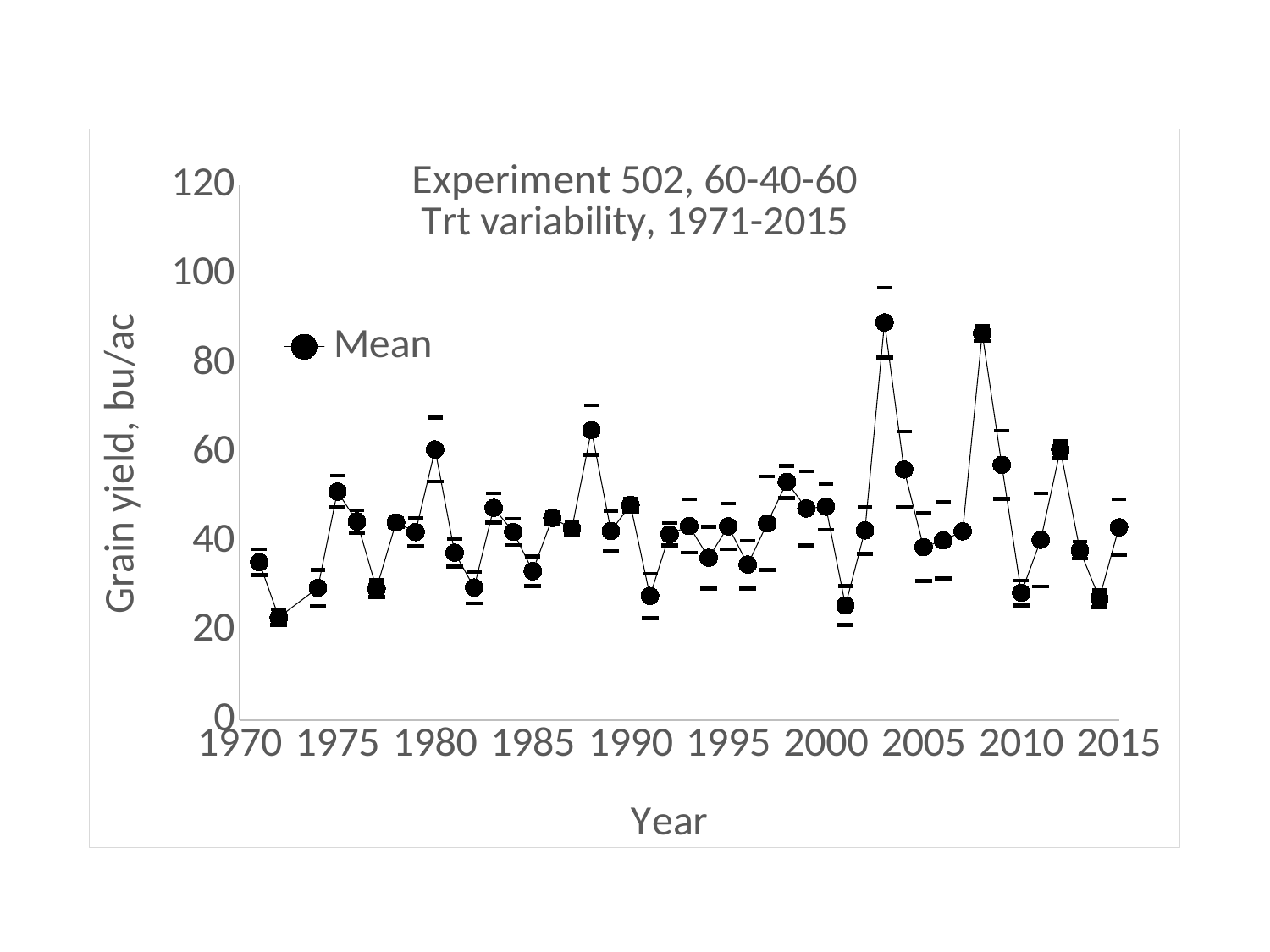
Is the mean grain yield for 2010 greater or less than 40? less Is the mean grain yield for 1980 greater or less than 40? greater What kind of chart is shown on the slide? line chart How many series does the legend list? 1 What is the label of the y axis? Grain yield, bu/ac Is the mean grain yield for 2003 greater or less than 80? greater Which year has the larger mean grain yield, 2003 or 1972? 2003 Which year has the larger mean grain yield, 1988 or 1991? 1988 What is the title of the chart? Experiment 502, 60-40-60 Trt variability, 1971-2015 Which year has the larger mean grain yield, 1980 or 1982? 1980